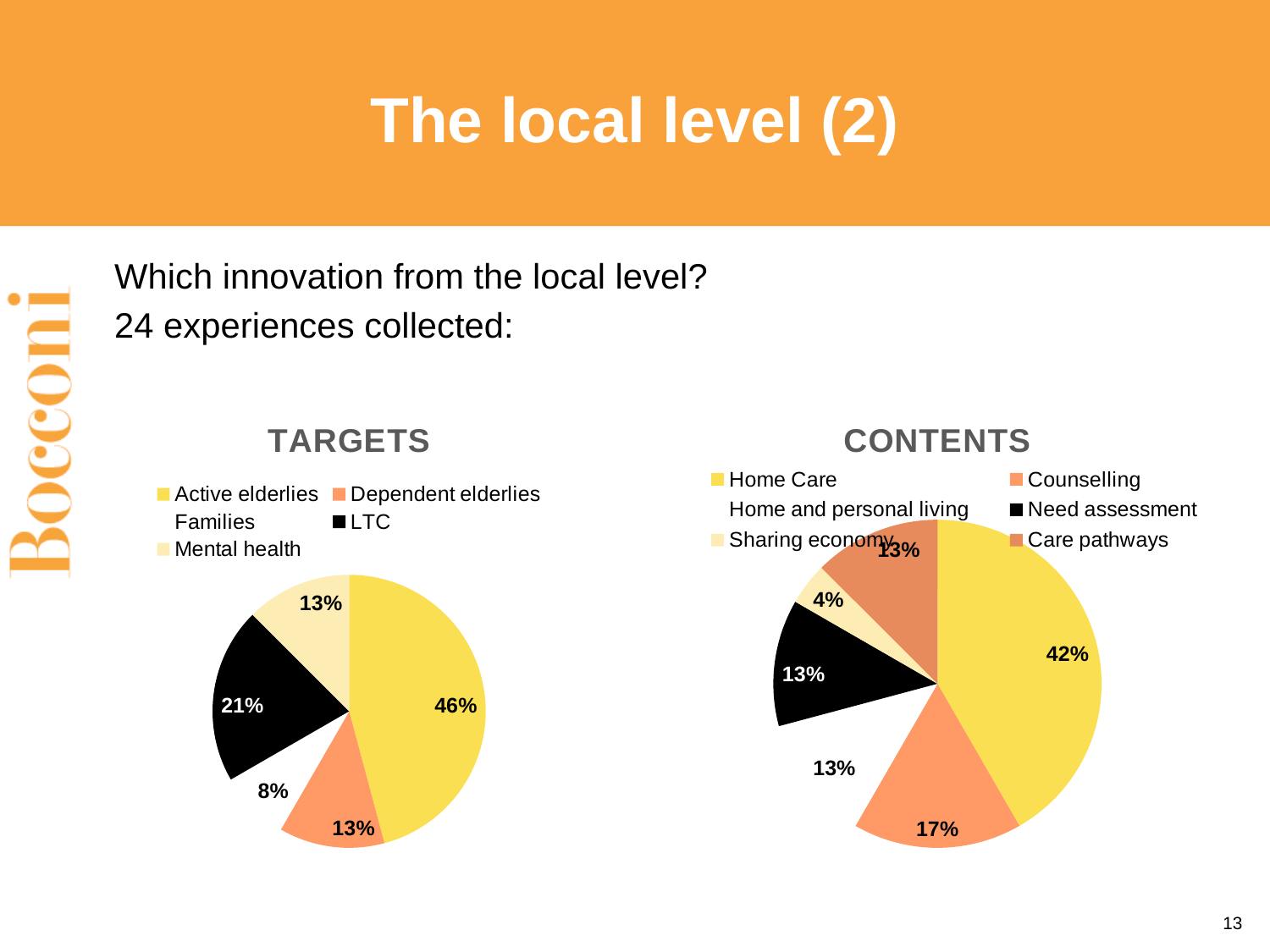
In the TARGETS chart, which target has the smallest share? Families In the CONTENTS chart, which content has the smallest share? Sharing economy In the CONTENTS chart, what percentage is shown for Counselling? 17% In the TARGETS chart, what percentage is shown for LTC? 21% In the TARGETS chart, what is the difference between the shares for Active elderlies and LTC? 25% In the CONTENTS chart, what share is shown for Home Care? 42% In the CONTENTS chart, which is larger, the share for Counselling or the share for Need assessment? Counselling What type of chart is used for the CONTENTS chart? Pie chart How many categories does the CONTENTS chart's legend list? 6 In the TARGETS chart, which target has the largest share? Active elderlies In the TARGETS chart, what share of experiences targets Active elderlies? 46% How many categories does the TARGETS chart's legend list? 5